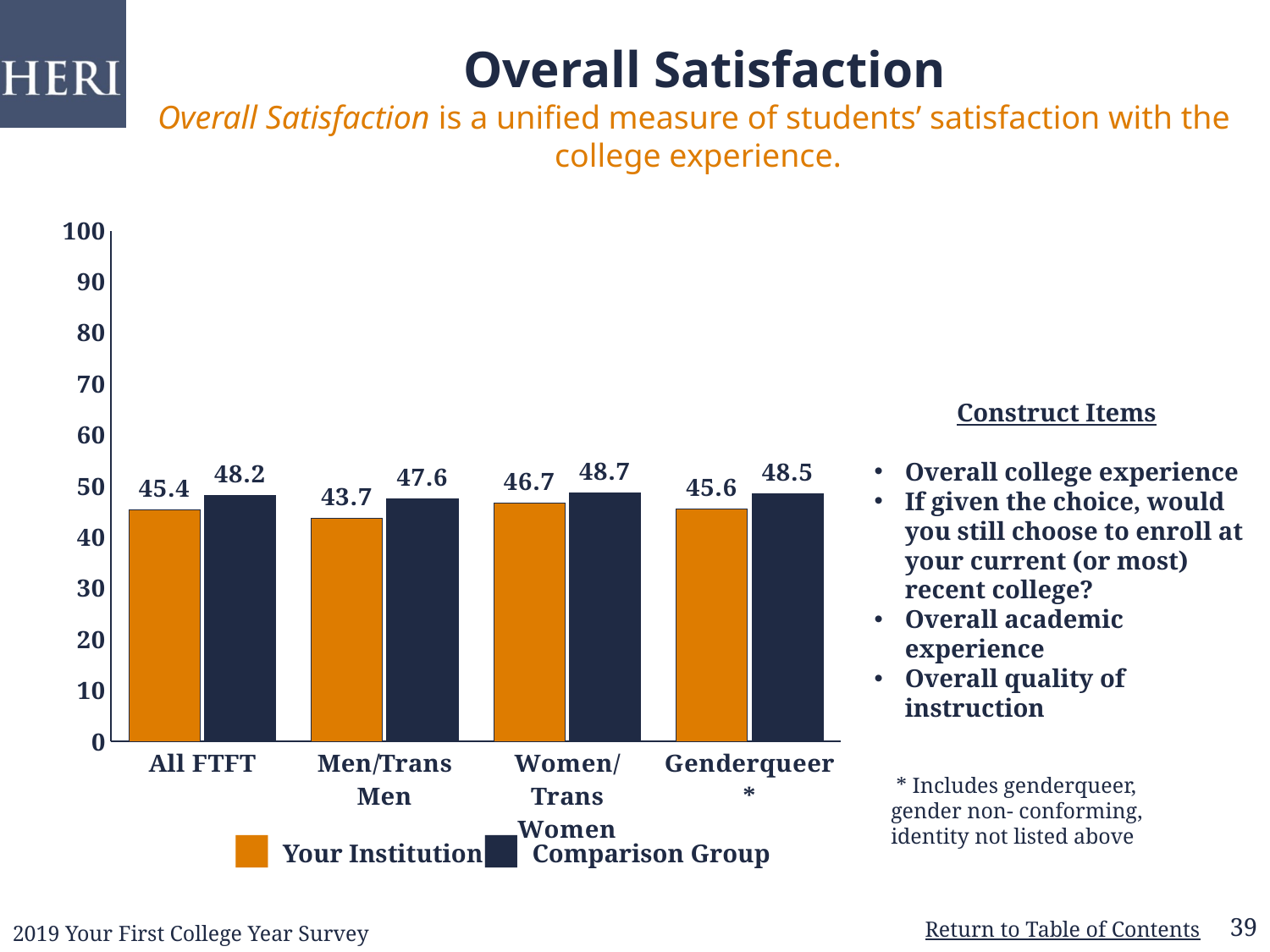
What kind of chart is shown on the slide? bar chart What is the Your Institution value for Genderqueer*? 45.6 How many categories are shown on the x axis? 4 What is the Your Institution value for All FTFT? 45.4 For All FTFT, which is larger: Your Institution or Comparison Group? Comparison Group Which colour represents Your Institution in the legend? orange How many series does the legend list? 2 Which category has the highest Comparison Group value? Women/Trans Women Is the Your Institution value for Women/Trans Women greater or less than 50? less What is the Comparison Group value for Women/Trans Women? 48.7 What is the difference between the Comparison Group and Your Institution values for Men/Trans Men? 3.9 Which category has the lowest Your Institution value? Men/Trans Men